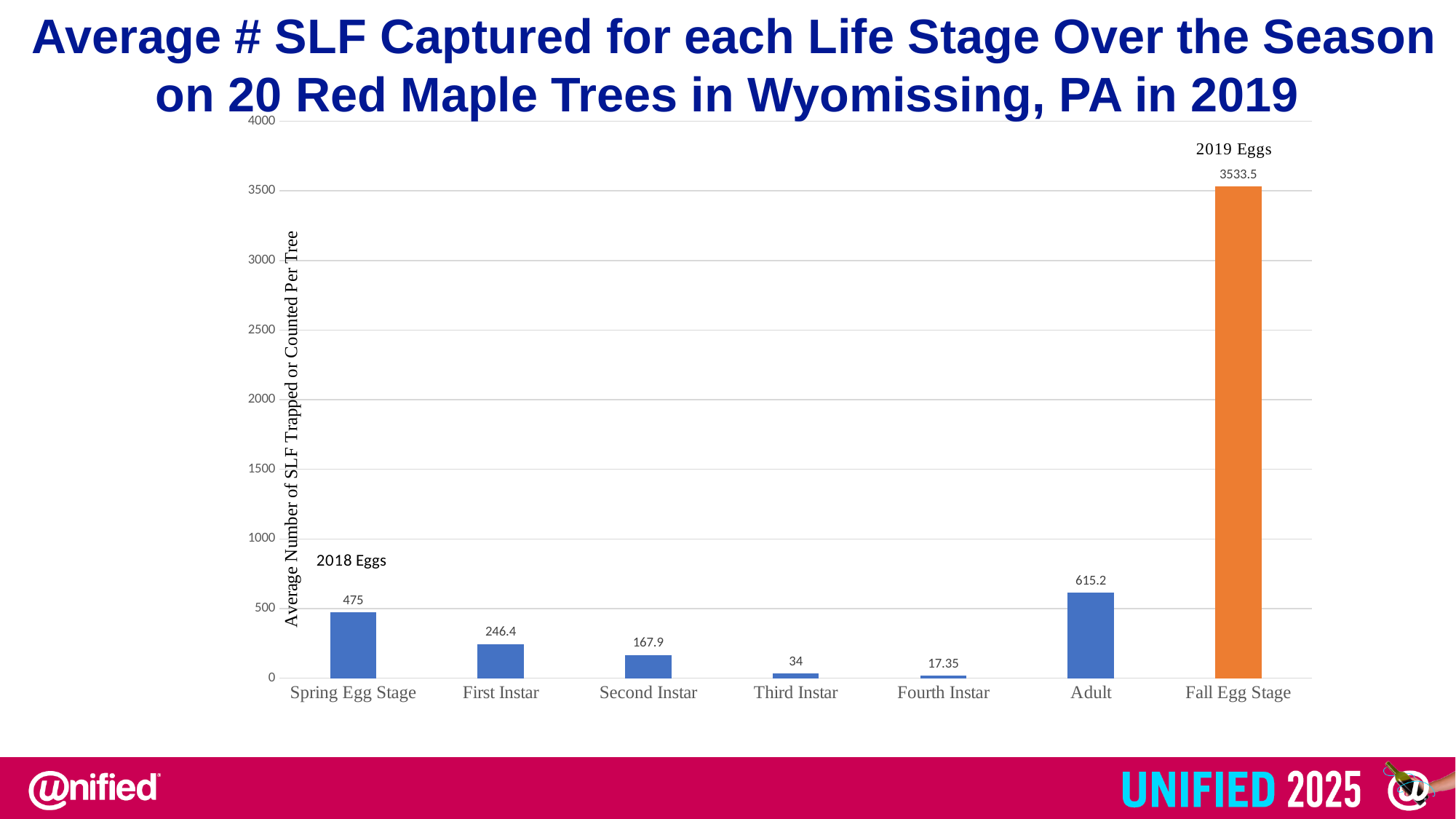
Is the value for Adult greater or less than 500? greater What is the value for Spring Egg Stage? 475 What is the label on the vertical axis? Average Number of SLF Trapped or Counted Per Tree What is the value for Adult? 615.2 What is the difference between the Fall Egg Stage and Spring Egg Stage values? 3058.5 What kind of chart is shown? Bar chart Which life stage has the lowest value? Fourth Instar Which life stage has the highest value? Fall Egg Stage Which is larger, the value for First Instar or the value for Second Instar? First Instar What is the value for Fourth Instar? 17.35 How many life stage categories are shown on the x axis? 7 What is the value for Fall Egg Stage? 3533.5